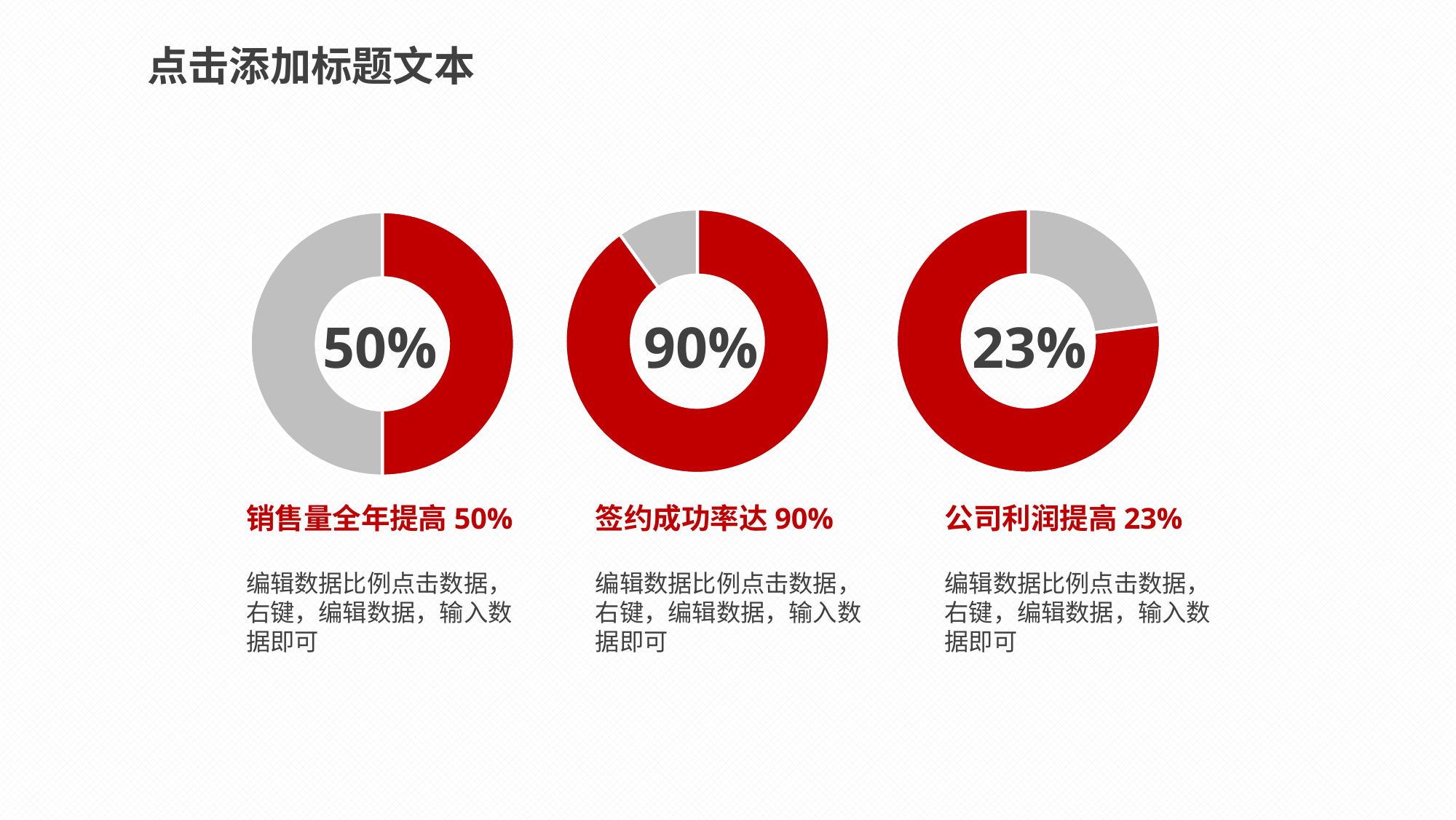
What percentage is printed in the centre of the left donut chart? 50% What percentage is printed in the centre of the right donut chart? 23% Is the percentage shown in the middle donut chart larger or smaller than the percentage shown in the right donut chart? larger What percentage is printed in the centre of the middle donut chart? 90% What is the difference between the percentage in the left donut chart and the percentage in the right donut chart? 27% How many donut charts are on the slide? 3 What is the difference between the percentage in the middle donut chart and the percentage in the left donut chart? 40% Which of the three donut charts shows the lowest percentage? the right chart (23%) What kind of chart is shown on the left of the slide? donut chart What two colours are used for the segments of the donut charts? red and grey What is the caption printed below the middle donut chart? 签约成功率达 90% Which of the three donut charts shows the highest percentage? the middle chart (90%)